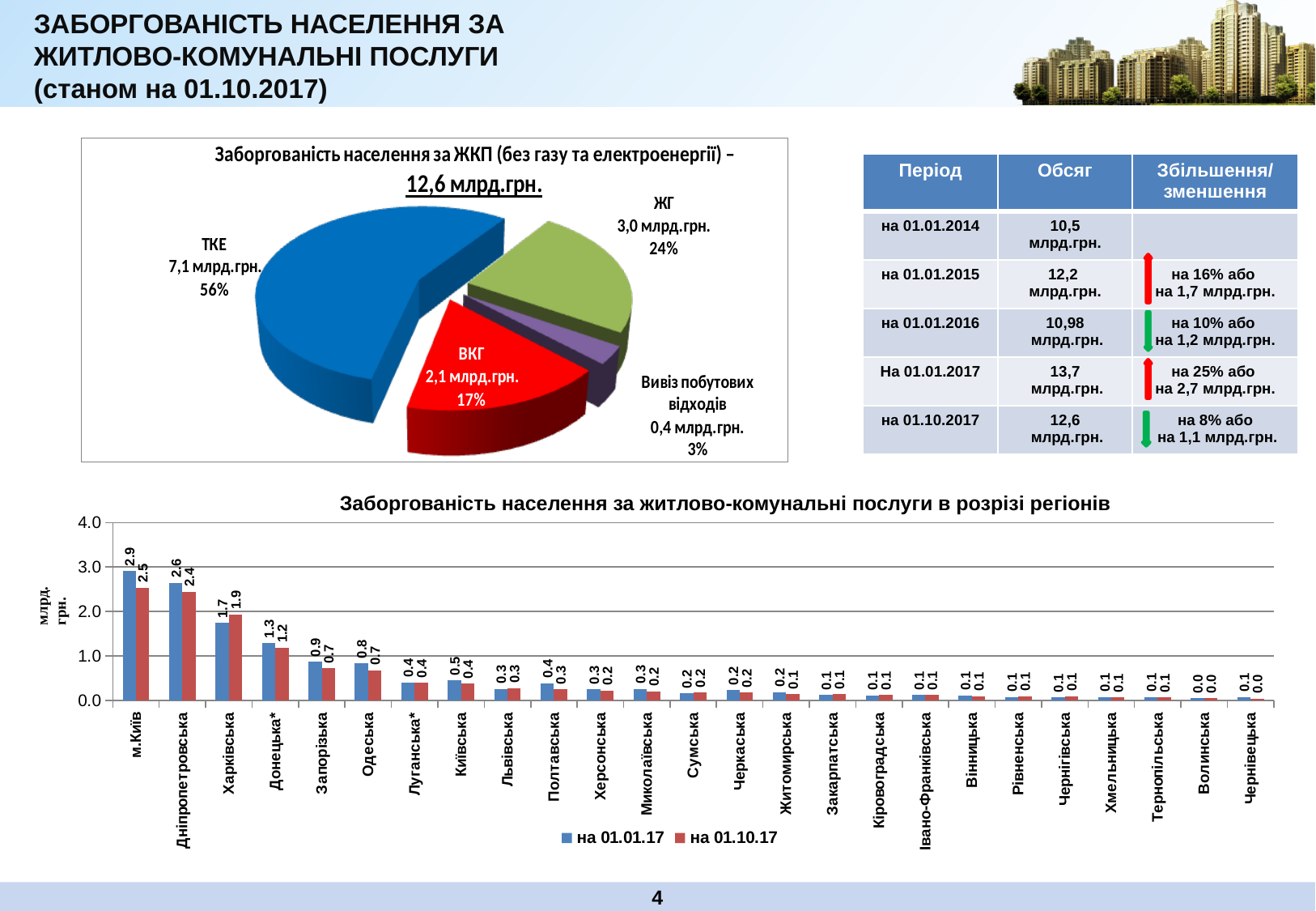
In the bar chart by region, how many regions are shown on the x axis? 25 In the pie chart, what is the debt value for ТКЕ? 7,1 млрд.грн. In the pie chart, which category has the smallest slice? Вивіз побутових відходів What type of chart is the bottom chart showing debt by region? bar chart In the pie chart, what share of the total does ЖГ account for? 24% In the bar chart by region, what is the value for Харківська on 01.10.17? 1.9 In the bar chart by region, what is the difference between the 01.01.17 and 01.10.17 values for м.Київ? 0.4 In the bar chart by region, which region has the highest value on 01.01.17? м.Київ In the pie chart, what total debt is stated in the title? 12,6 млрд.грн. In the bar chart by region, which is larger for Харківська: the value on 01.01.17 or on 01.10.17? на 01.10.17 In the pie chart, how many slices are shown? 4 In the bar chart by region, how many series does the legend list? 2